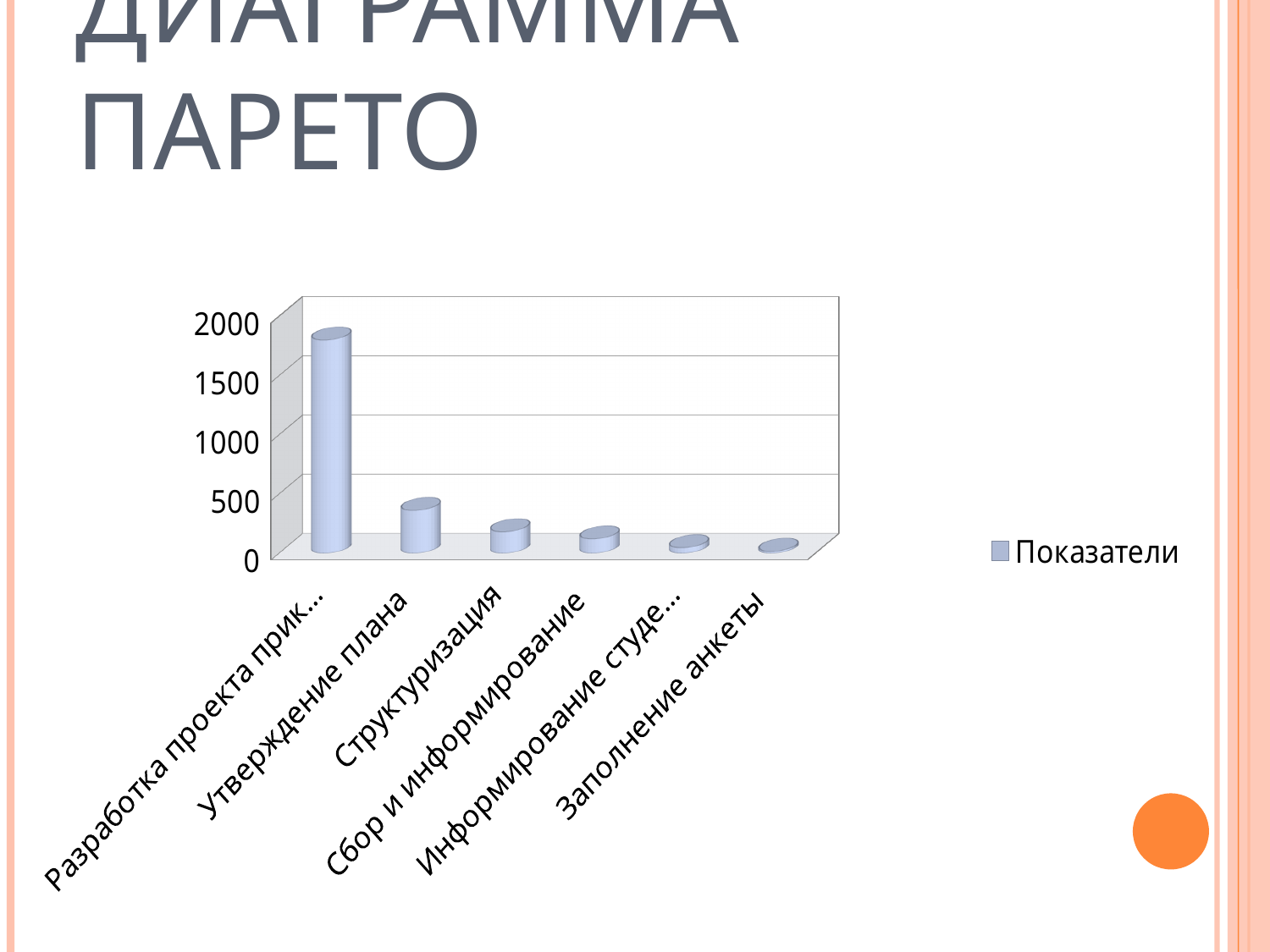
Is the value for Сбор и информирование greater or less than 1000? less What kind of chart is shown on the slide? bar chart What is the title of the slide containing the chart? Диаграмма Парето What is the name of the series shown in the chart's legend? Показатели Is the value for Утверждение плана greater or less than 500? less Do the values rise or fall from left to right along the x axis? fall Which is larger, the value for Структуризация or the value for Заполнение анкеты? Структуризация How many categories are shown on the x axis of the chart? 6 How many series does the chart's legend list? 1 Is the value for the leftmost bar greater or less than 1500? greater Which is larger, the value for Утверждение плана or the value for Структуризация? Утверждение плана